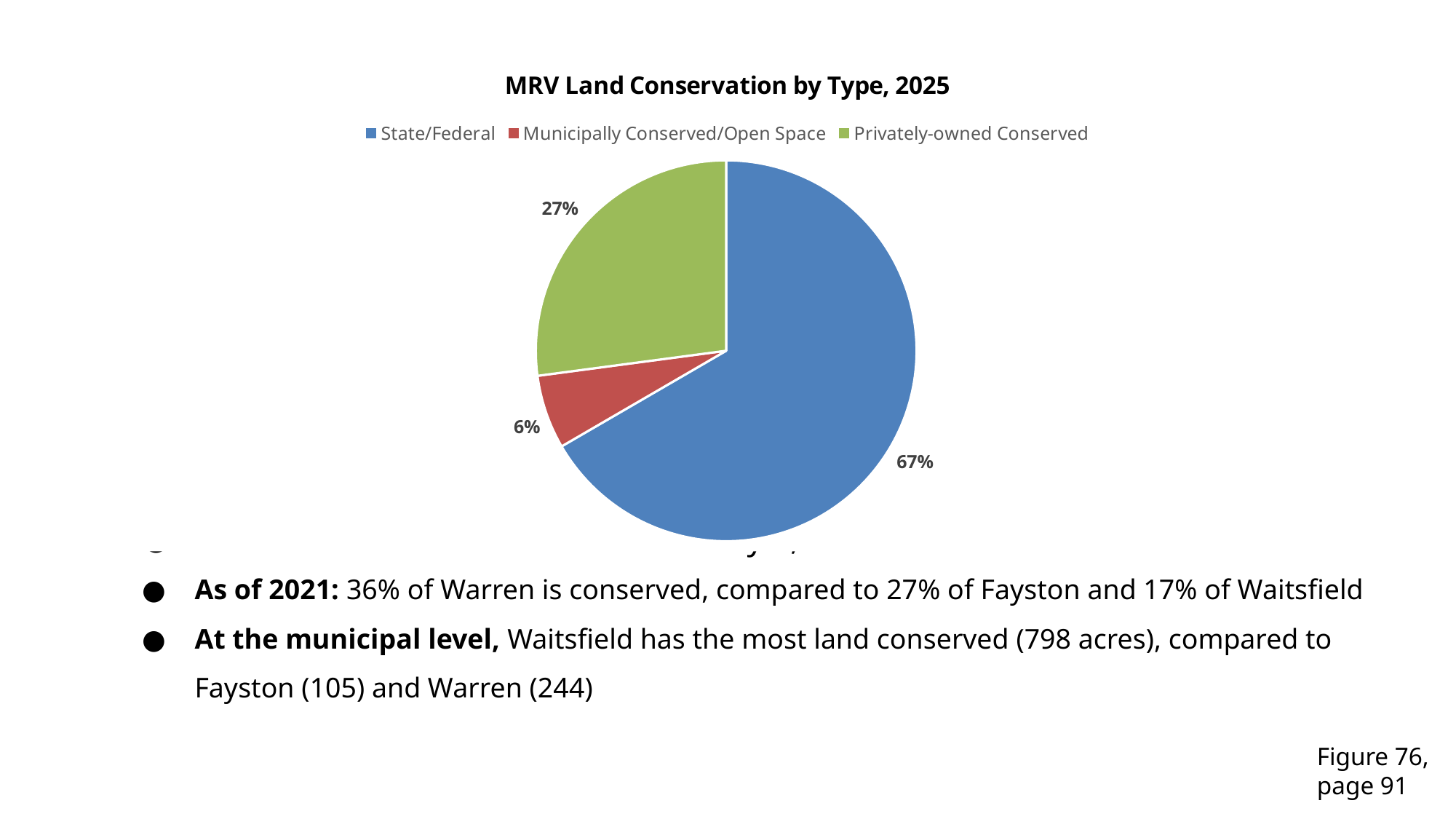
Which is larger, the Privately-owned Conserved slice or the Municipally Conserved/Open Space slice? Privately-owned Conserved What is the difference in percentage points between the State/Federal slice and the Privately-owned Conserved slice? 40 What share of the pie is Privately-owned Conserved? 27% What share of the pie is Municipally Conserved/Open Space? 6% Which category has the smallest slice of the pie? Municipally Conserved/Open Space What share of the pie is State/Federal? 67% What type of chart is shown on the slide? Pie chart Which category has the largest slice of the pie? State/Federal How many categories does the pie chart show? 3 What is the combined share of the Municipally Conserved/Open Space and Privately-owned Conserved slices? 33% What is the title of the chart? MRV Land Conservation by Type, 2025 What colour is the State/Federal slice? Blue